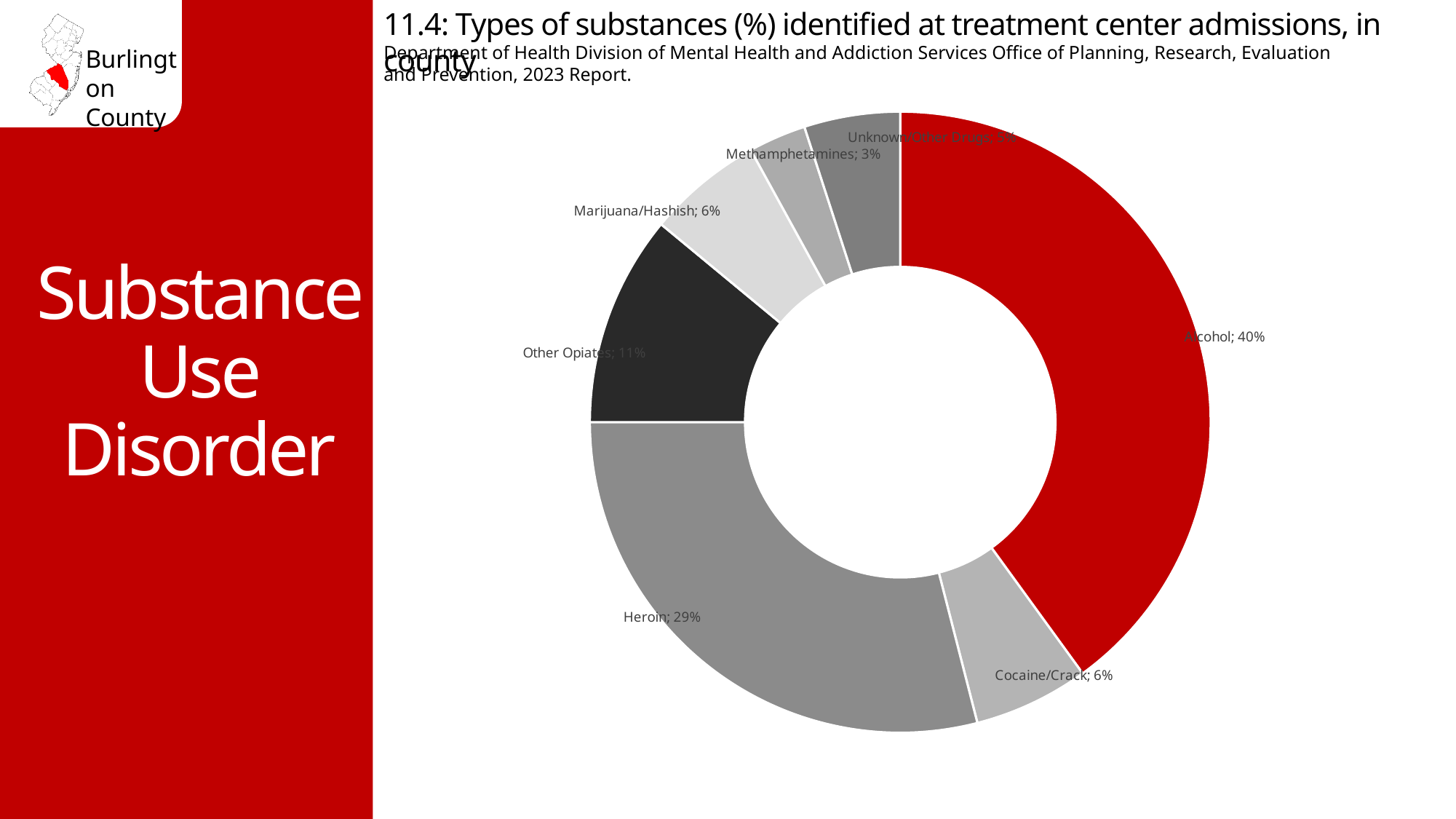
What is the difference in percentage points between Alcohol and Heroin? 11 How many substance categories are shown in the chart? 7 What colour is the Alcohol segment of the chart? Red What percentage is shown for Unknown/Other Drugs? 5% What percentage is shown for Other Opiates? 11% What kind of chart is shown on the slide? Doughnut (pie) chart Which substance has the largest share of treatment center admissions? Alcohol What percentage is shown for Methamphetamines? 3% What percentage is shown for Heroin? 29% What percentage is shown for Alcohol? 40% Which substance has the smallest share of treatment center admissions? Methamphetamines Which is larger, the share for Other Opiates or the share for Cocaine/Crack? Other Opiates